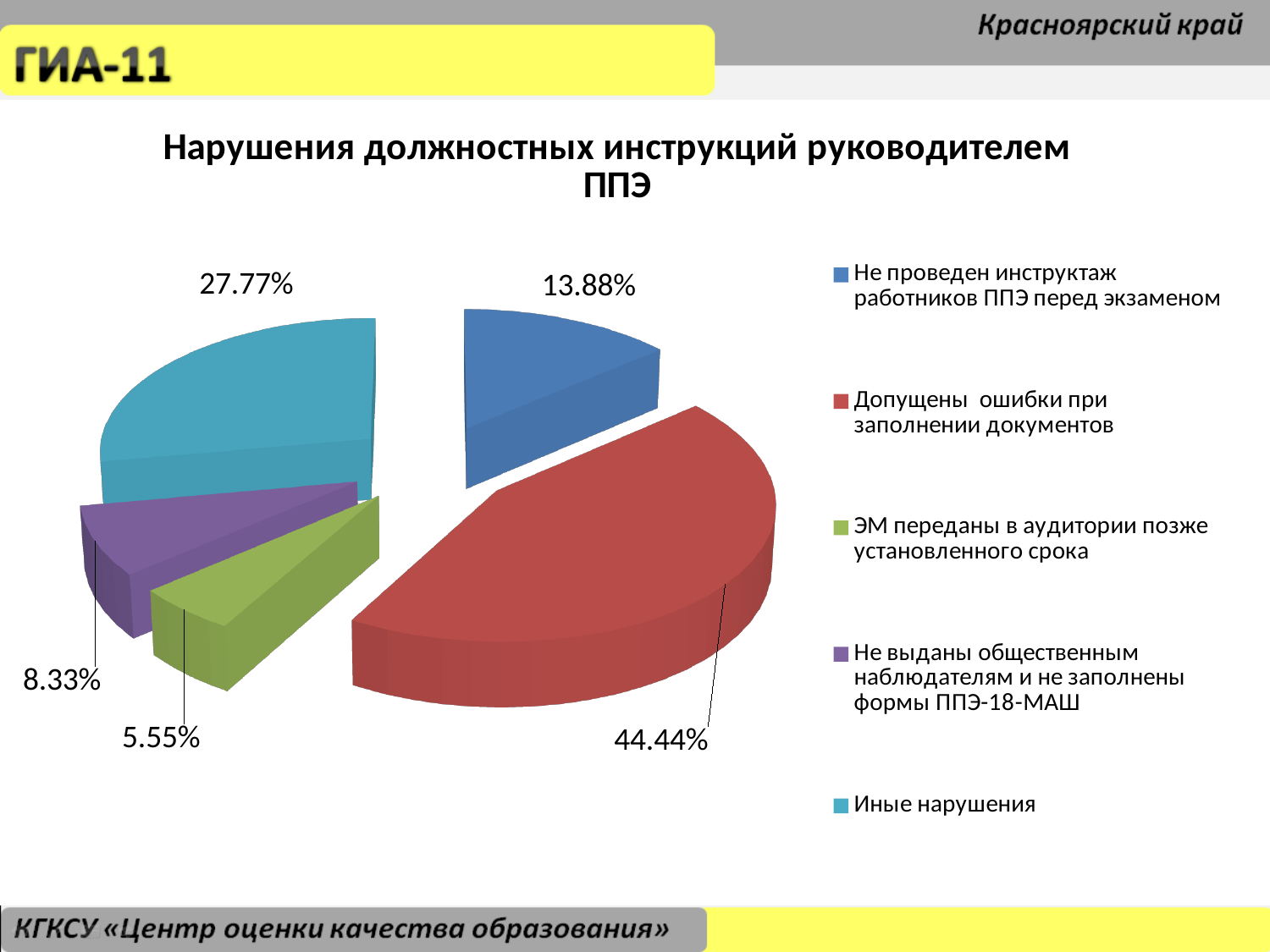
Which category has the largest share of the pie? Допущены ошибки при заполнении документов What is the difference in percentage points between "Допущены ошибки при заполнении документов" and "Иные нарушения"? 16.67 What type of chart is shown on the slide? Pie chart Which is larger: the share for "Иные нарушения" or the share for "Не проведен инструктаж работников ППЭ перед экзаменом"? Иные нарушения Which category has the smallest share of the pie? ЭМ переданы в аудитории позже установленного срока What is the share for "ЭМ переданы в аудитории позже установленного срока"? 5.55% How many categories does the pie chart show? 5 What is the share for "Иные нарушения"? 27.77% What is the title of the chart? Нарушения должностных инструкций руководителем ППЭ What is the share for "Допущены ошибки при заполнении документов"? 44.44% What is the share for "Не выданы общественным наблюдателям и не заполнены формы ППЭ-18-МАШ"? 8.33% What is the share for "Не проведен инструктаж работников ППЭ перед экзаменом"? 13.88%